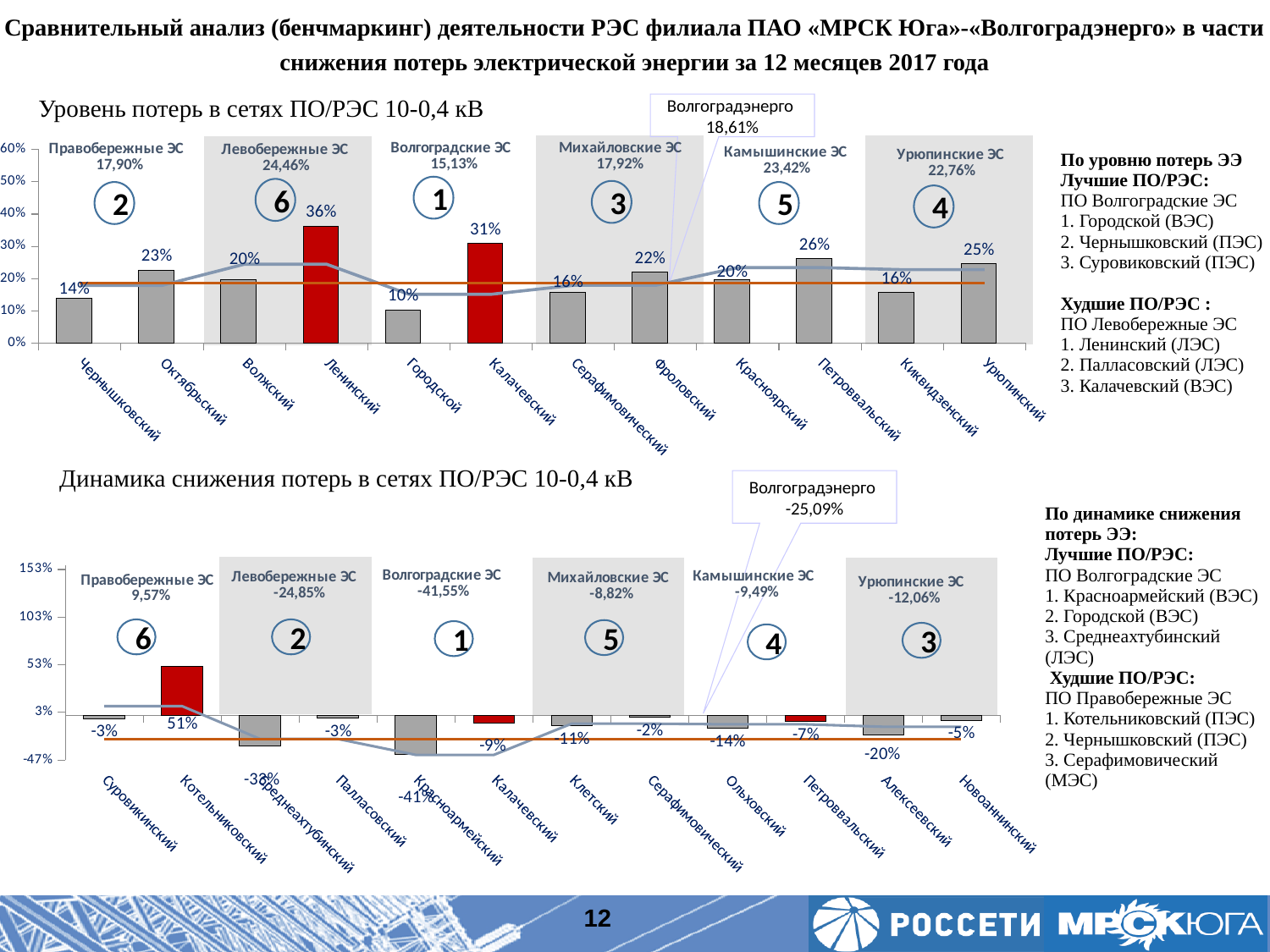
In the top chart 'Уровень потерь в сетях ПО/РЭС 10-0,4 кВ', what is the value for Ленинский? 36% In the bottom chart 'Динамика снижения потерь в сетях ПО/РЭС 10-0,4 кВ', what is the value for Красноармейский? -41% How many categories are plotted in the top chart 'Уровень потерь в сетях ПО/РЭС 10-0,4 кВ'? 12 In the top chart 'Уровень потерь в сетях ПО/РЭС 10-0,4 кВ', what is the value for Городской? 10% In the top chart 'Уровень потерь в сетях ПО/РЭС 10-0,4 кВ', which category has the lowest value? Городской In the top chart 'Уровень потерь в сетях ПО/РЭС 10-0,4 кВ', which is larger: the value for Петроввальский or the value for Фроловский? Петроввальский In the top chart 'Уровень потерь в сетях ПО/РЭС 10-0,4 кВ', what value is shown in the callout for Волгоградэнерго? 18,61% In the bottom chart 'Динамика снижения потерь в сетях ПО/РЭС 10-0,4 кВ', what is the value for Котельниковский? 51% In the top chart 'Уровень потерь в сетях ПО/РЭС 10-0,4 кВ', what is the difference between the values for Калачевский and Чернышковский? 17% What kind of chart is the top chart 'Уровень потерь в сетях ПО/РЭС 10-0,4 кВ'? Combination bar and line chart In the bottom chart 'Динамика снижения потерь в сетях ПО/РЭС 10-0,4 кВ', which category has the lowest value? Красноармейский In the top chart 'Уровень потерь в сетях ПО/РЭС 10-0,4 кВ', which category has the highest value? Ленинский